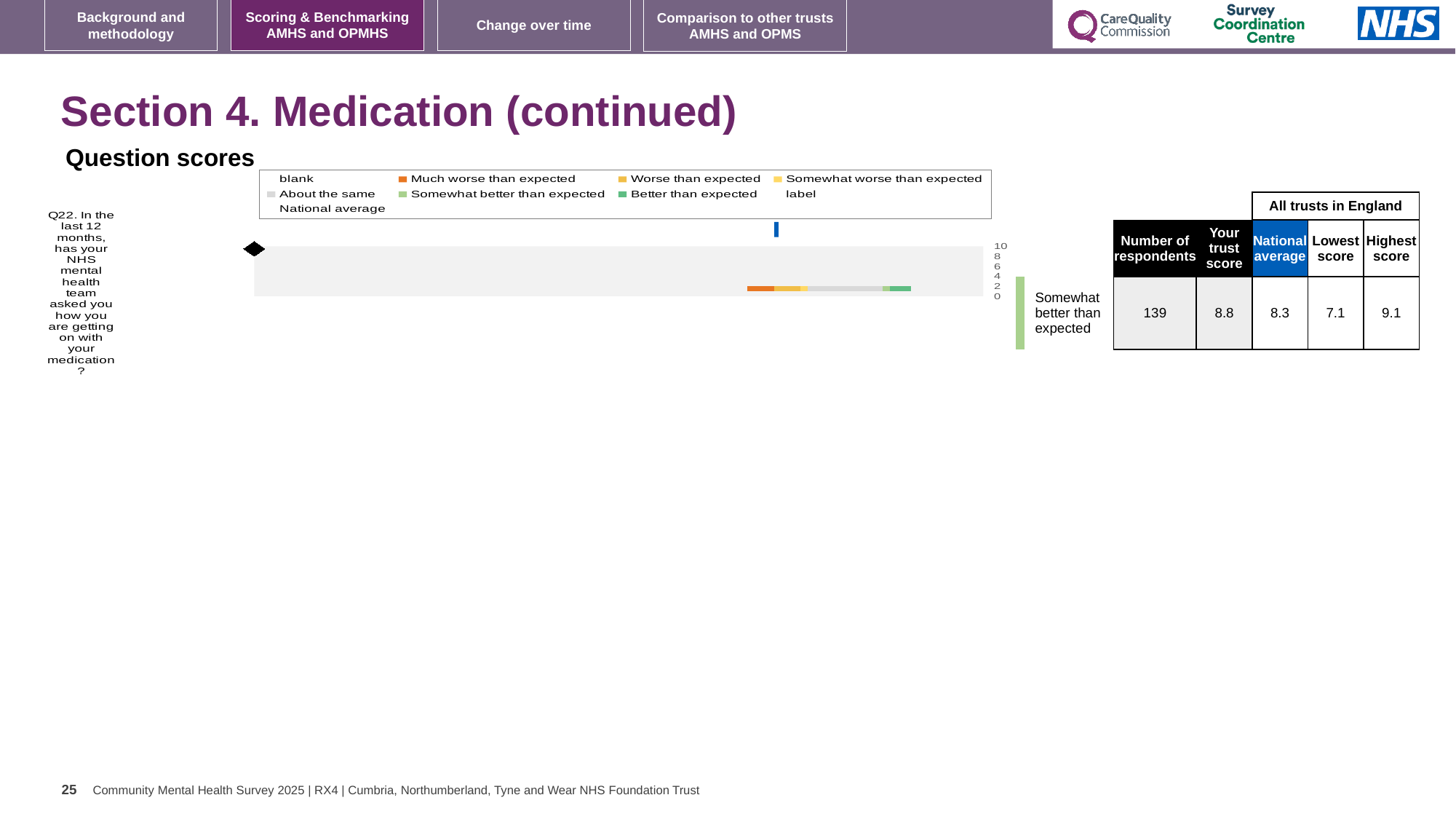
What benchmark category is written next to the chart for Q22? Somewhat better than expected In the table beside the chart, what is the difference between the highest score and the lowest score for Q22? 2.0 In the table beside the chart, what is 'Your trust score' for Q22? 8.8 Which question number is plotted in the chart? Q22 In the table beside the chart, what is the national average for Q22? 8.3 Which legend entry is shown in orange? Much worse than expected What kind of chart is shown under 'Question scores'? bar chart In the table beside the chart, is the lowest score for Q22 greater or less than 8? less In the table beside the chart, which is larger for Q22: your trust score or the national average? Your trust score What is the highest value shown on the chart's axis? 10 How many questions (categories) are plotted in the chart? 1 In the table beside the chart, what is the number of respondents for Q22? 139